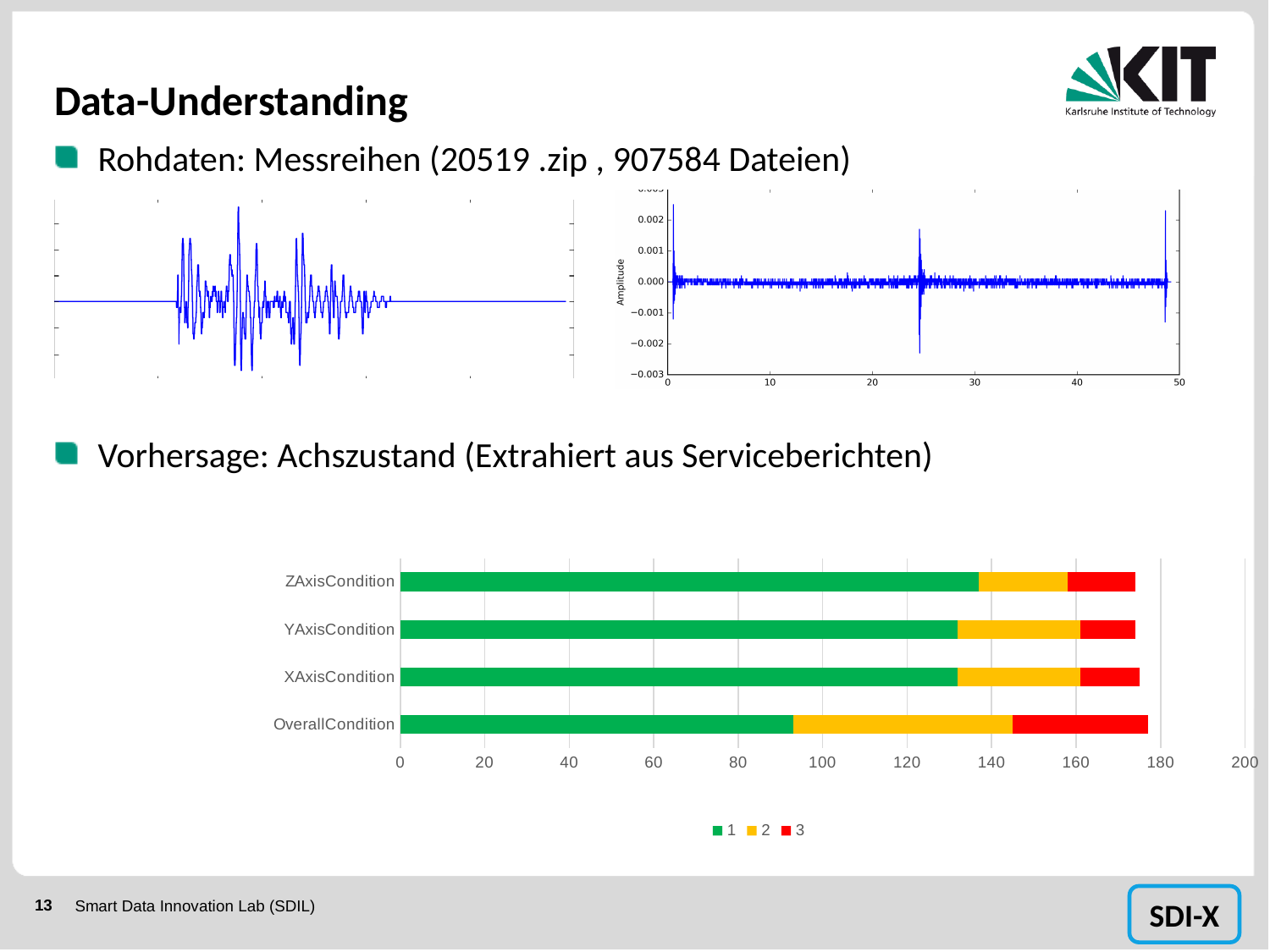
What kind of chart is the chart at the bottom of the slide? bar chart On the bottom bar chart, is the value of series 1 for XAxisCondition greater or less than 140? less On the bottom bar chart, which category has the largest value for series 2? OverallCondition On the bottom bar chart, is the total of the stacked bar for OverallCondition greater or less than 160? greater On the bottom bar chart, which category has the largest value for series 3? OverallCondition How many categories are shown on the bottom bar chart? 4 How many series does the legend of the bottom bar chart list? 3 On the bottom bar chart, which category has the smallest value for series 1? OverallCondition On the bottom bar chart, is the value of series 1 larger for ZAxisCondition or for OverallCondition? ZAxisCondition What is the y-axis label of the line chart at the top right of the slide? Amplitude On the bottom bar chart, is the value of series 1 for OverallCondition greater or less than 100? less